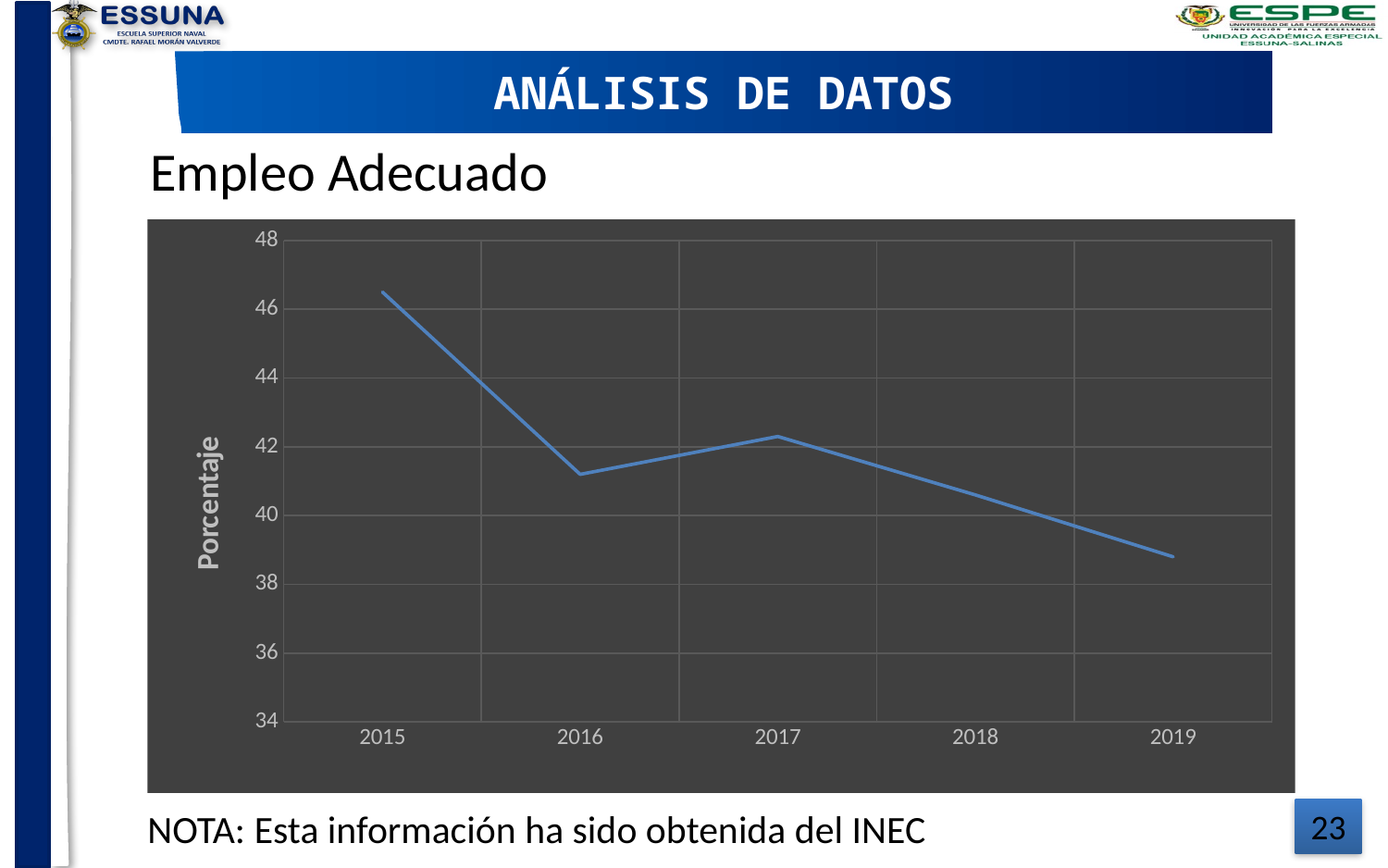
Is the value for 2018 greater or less than 42? less Is the value for 2015 greater or less than 44? greater What is the label on the vertical axis of the chart? Porcentaje Is the value for 2017 greater or less than 44? less How many years are plotted on the x axis of the chart? 5 Which year has the lowest value in the chart? 2019 Which year has the highest value in the chart? 2015 Overall, do the values rise or fall from 2015 to 2019? fall What type of chart is shown on the slide? line chart Which is larger, the value for 2016 or the value for 2017? 2017